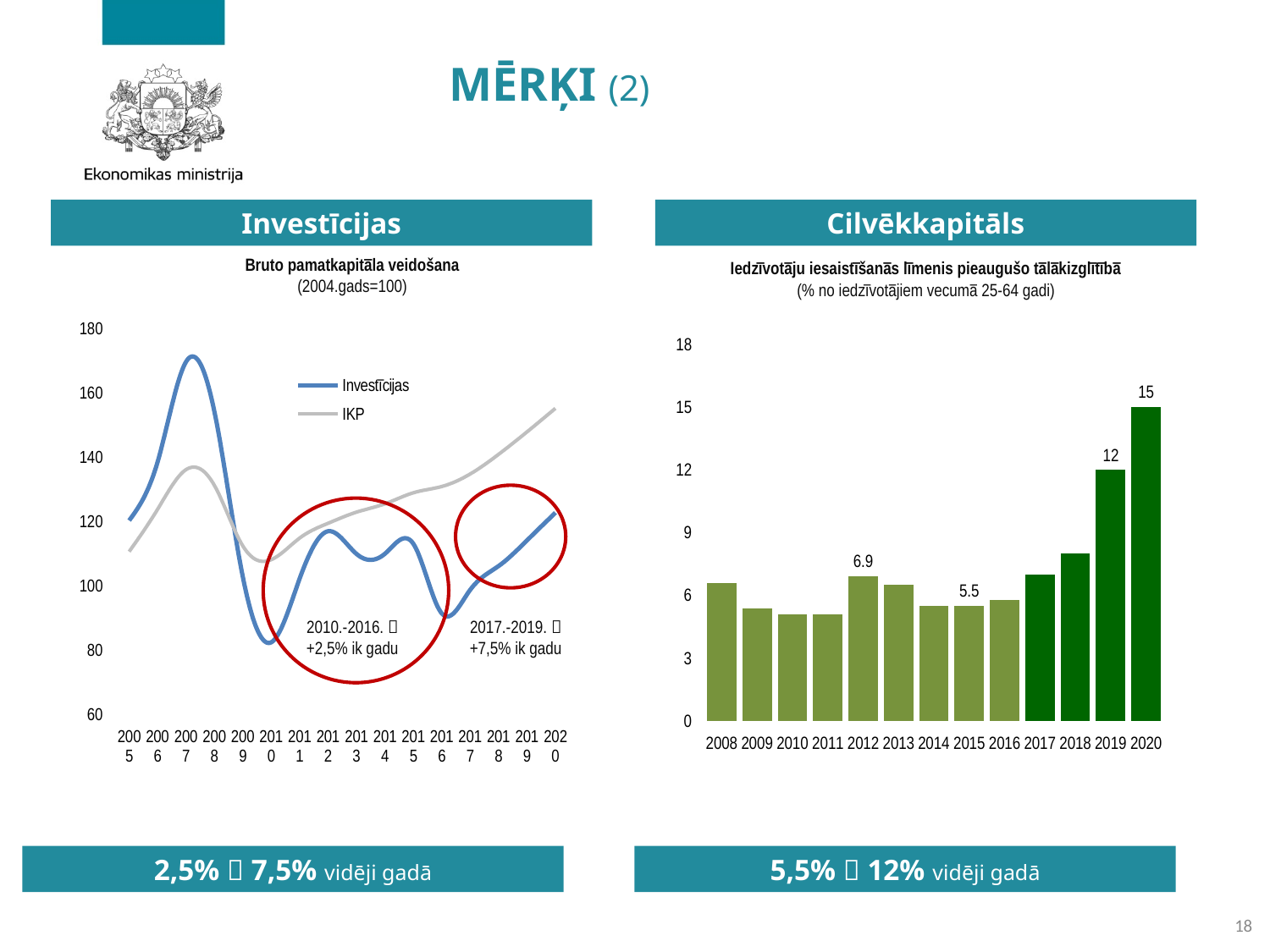
On the chart titled 'Iedzīvotāju iesaistīšanās līmenis pieaugušo tālākizglītībā', what is the value for 2020? 15 How many series does the legend of the chart titled 'Bruto pamatkapitāla veidošana' list? 2 On the chart titled 'Iedzīvotāju iesaistīšanās līmenis pieaugušo tālākizglītībā', how many years are shown on the x axis? 13 On the chart titled 'Iedzīvotāju iesaistīšanās līmenis pieaugušo tālākizglītībā', what is the value for 2015? 5.5 On the chart titled 'Iedzīvotāju iesaistīšanās līmenis pieaugušo tālākizglītībā', what is the difference between the values for 2020 and 2019? 3 On the chart titled 'Bruto pamatkapitāla veidošana', is the Investīcijas value for 2007 greater or less than 160? greater What kind of chart is the one titled 'Iedzīvotāju iesaistīšanās līmenis pieaugušo tālākizglītībā'? bar chart On the chart titled 'Iedzīvotāju iesaistīšanās līmenis pieaugušo tālākizglītībā', which year has the highest value? 2020 What kind of chart is the one titled 'Bruto pamatkapitāla veidošana'? line chart On the chart titled 'Iedzīvotāju iesaistīšanās līmenis pieaugušo tālākizglītībā', which is larger, the value for 2012 or the value for 2015? 2012 On the chart titled 'Iedzīvotāju iesaistīšanās līmenis pieaugušo tālākizglītībā', is the value for 2018 greater or less than 9? less On the chart titled 'Iedzīvotāju iesaistīšanās līmenis pieaugušo tālākizglītībā', what is the value for 2012? 6.9